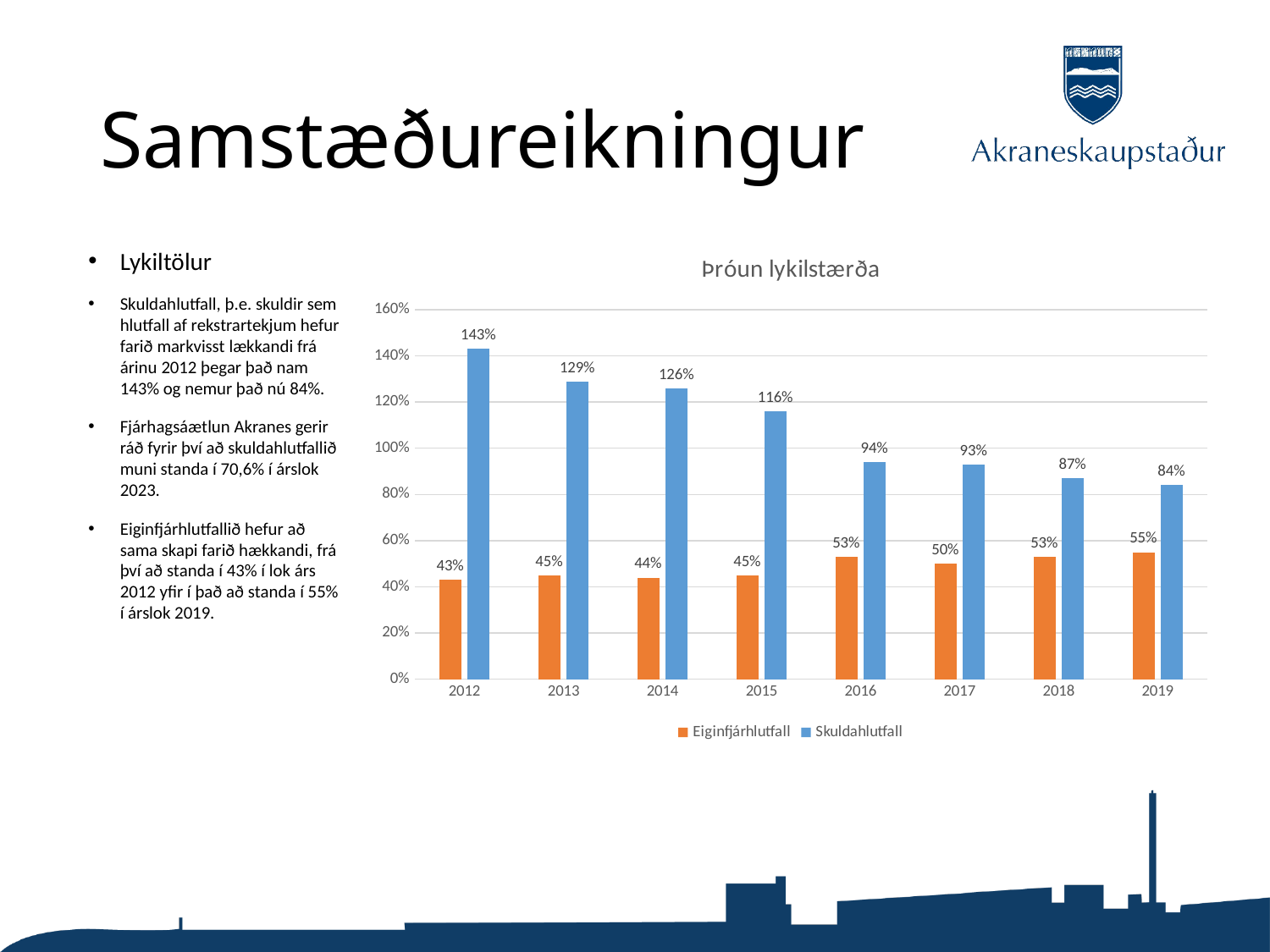
What kind of chart is shown? bar chart Which year has the highest Skuldahlutfall? 2012 Which is larger: Skuldahlutfall in 2014 or Skuldahlutfall in 2015? 2014 What is the value of Skuldahlutfall for 2012? 143% What is the value of Eiginfjárhlutfall for 2019? 55% How many series does the legend list? 2 Which year has the lowest Eiginfjárhlutfall? 2012 What is the difference between Skuldahlutfall in 2012 and in 2019? 59% How many years are shown on the x axis? 8 What is the value of Skuldahlutfall for 2016? 94% What is the title of the chart? Þróun lykilstærða Does Skuldahlutfall rise or fall from 2012 to 2019? fall